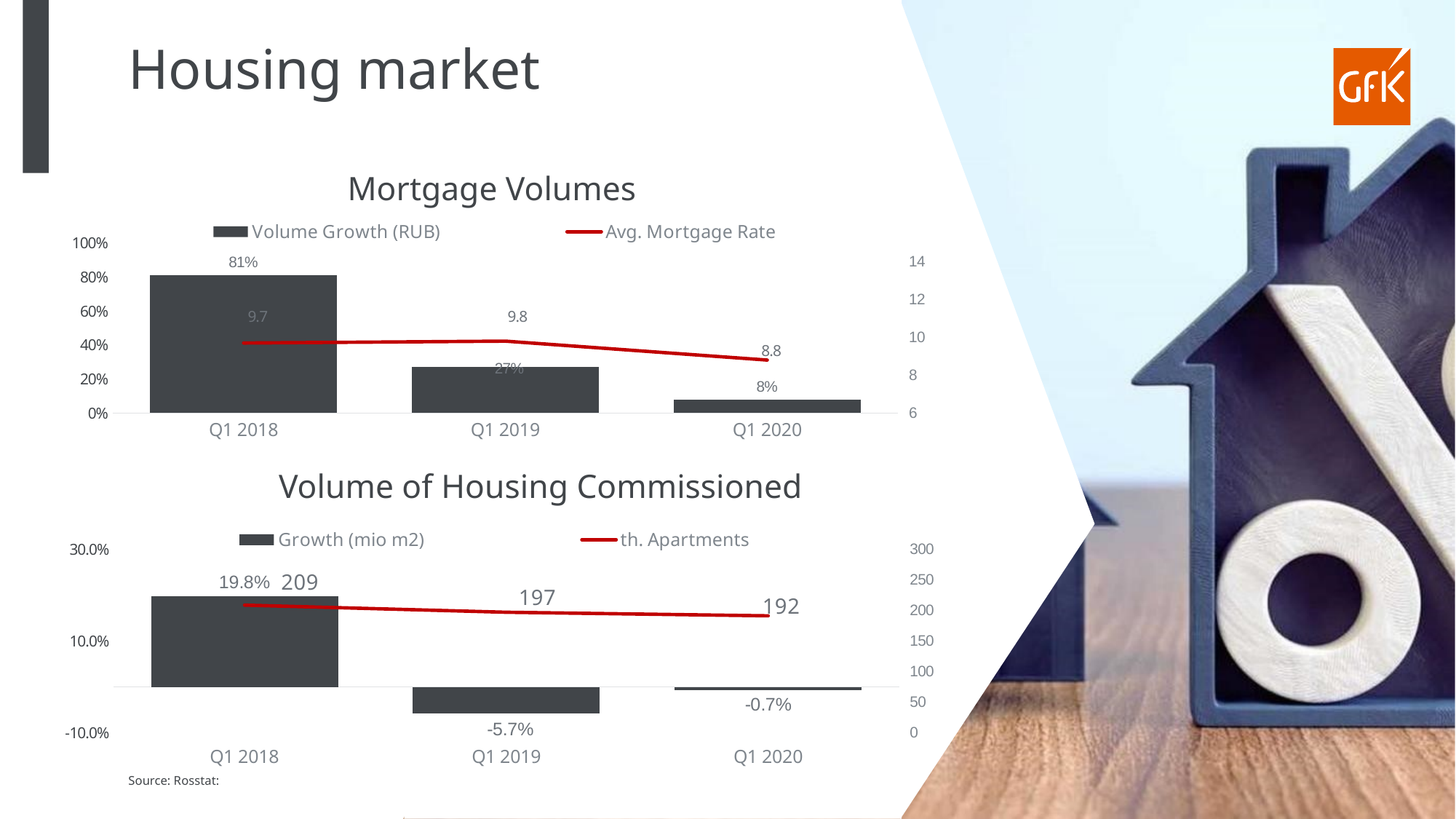
In the Mortgage Volumes chart, what is the Avg. Mortgage Rate for Q1 2020? 8.8 How many quarters are shown on the x axis of the Volume of Housing Commissioned chart? 3 How many series does the legend of the Mortgage Volumes chart list? 2 In the Volume of Housing Commissioned chart, what is the th. Apartments value for Q1 2018? 209 In the Volume of Housing Commissioned chart, what is the difference in th. Apartments between Q1 2018 and Q1 2020? 17 In the Mortgage Volumes chart, what is the Volume Growth (RUB) for Q1 2018? 81% In the Mortgage Volumes chart, does Volume Growth (RUB) rise or fall from Q1 2018 to Q1 2020? fall In the Mortgage Volumes chart, what is the difference in Volume Growth (RUB) between Q1 2018 and Q1 2019? 54% In the Mortgage Volumes chart, what is the Avg. Mortgage Rate for Q1 2019? 9.8 In the Volume of Housing Commissioned chart, which quarter has the highest Growth (mio m2)? Q1 2018 In the Mortgage Volumes chart, which quarter has the lowest Volume Growth (RUB)? Q1 2020 In the Volume of Housing Commissioned chart, what is the Growth (mio m2) for Q1 2019? -5.7%